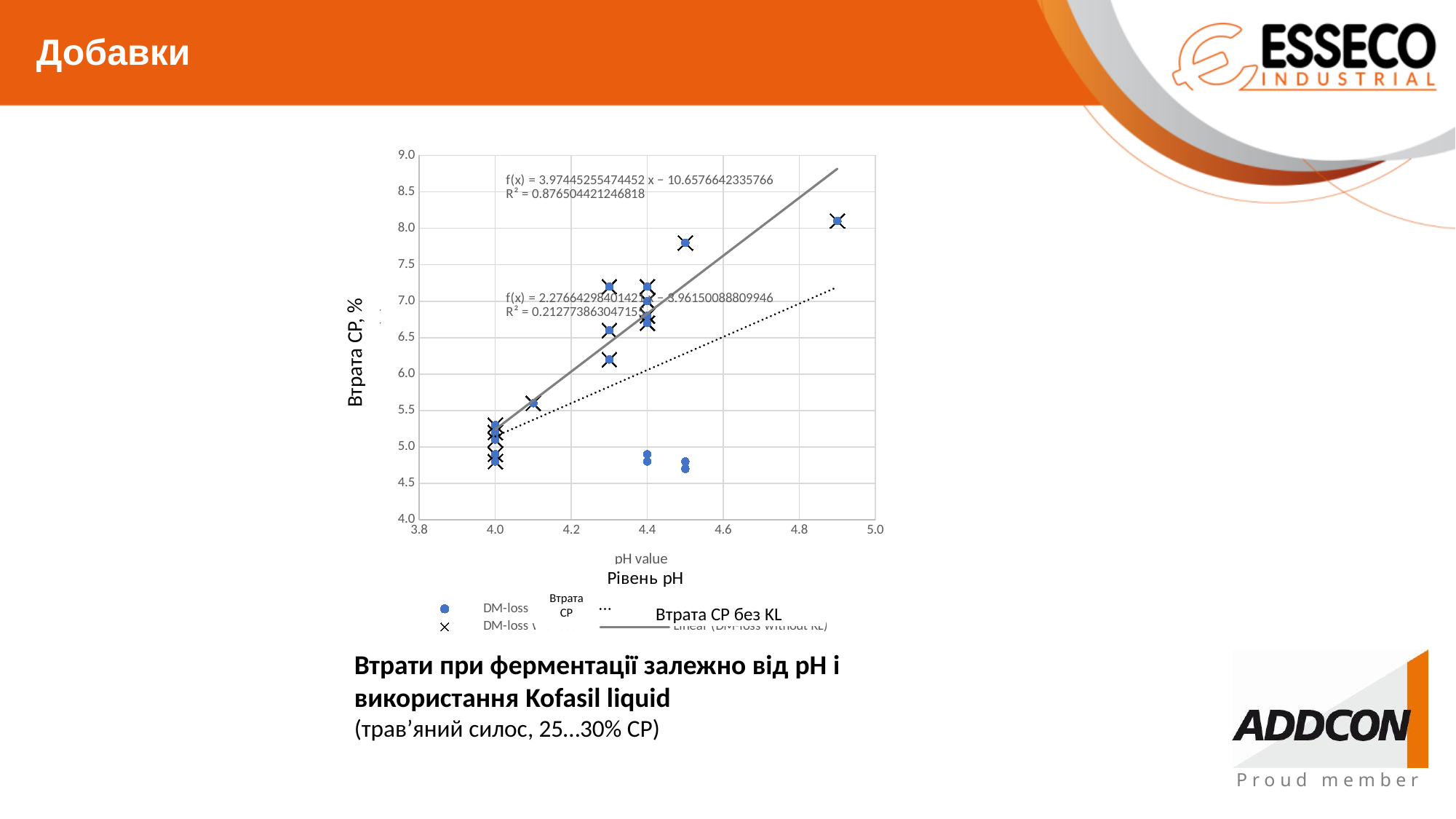
Are the blue dot points at pH 4.4 greater or less than 5.0? less Are the values of the blue dot points at pH 4.5 greater or less than 5.0? less Is the value of the x-marker point at pH 4.5 greater or less than 7.0? greater At pH 4.5, which is larger: the x-marker point or the blue dot points? The x-marker point At which pH value is the highest plotted point on the chart located? 4.9 What is the label of the vertical axis of the chart? Втрата СР, % What kind of chart is shown on the slide? Scatter chart What R² value is printed for the upper (solid) trendline on the chart? 0.876504421246818 Does the solid trendline rise or fall as pH increases along the x axis? Rises What is the highest value shown on the vertical axis of the chart? 9.0